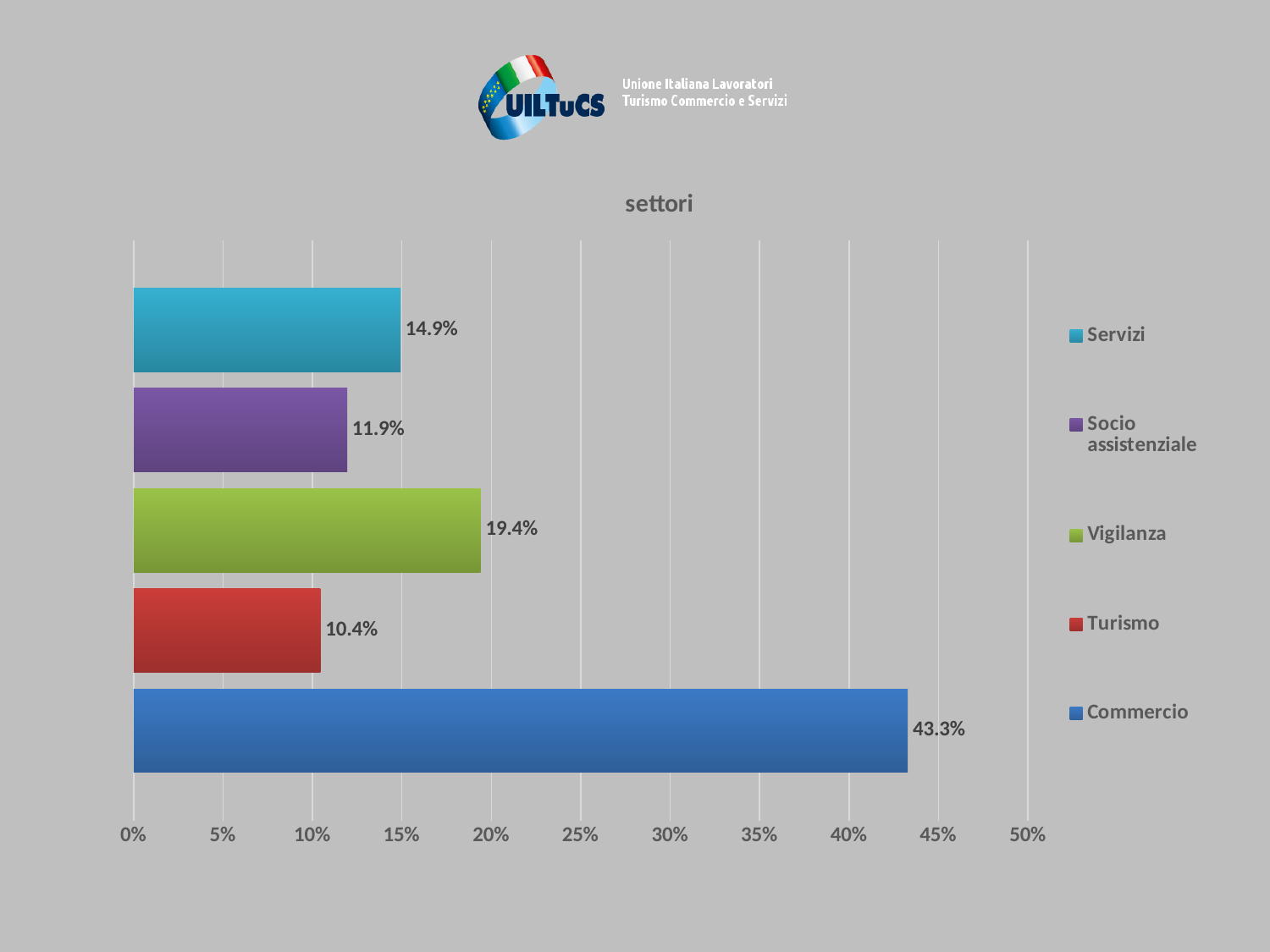
What is the value for Commercio? 43.3% What is the value for Vigilanza? 19.4% How many categories are shown in the chart? 5 What is the difference between the values for Commercio and Vigilanza? 23.9% What kind of chart is shown on the slide? bar chart What is the value for Socio assistenziale? 11.9% Which is larger, the value for Servizi or the value for Socio assistenziale? Servizi What is the title of the chart? settori Which category has the lowest value? Turismo Is the value for Commercio greater or less than 40%? greater Which category has the highest value? Commercio What is the value for Turismo? 10.4%